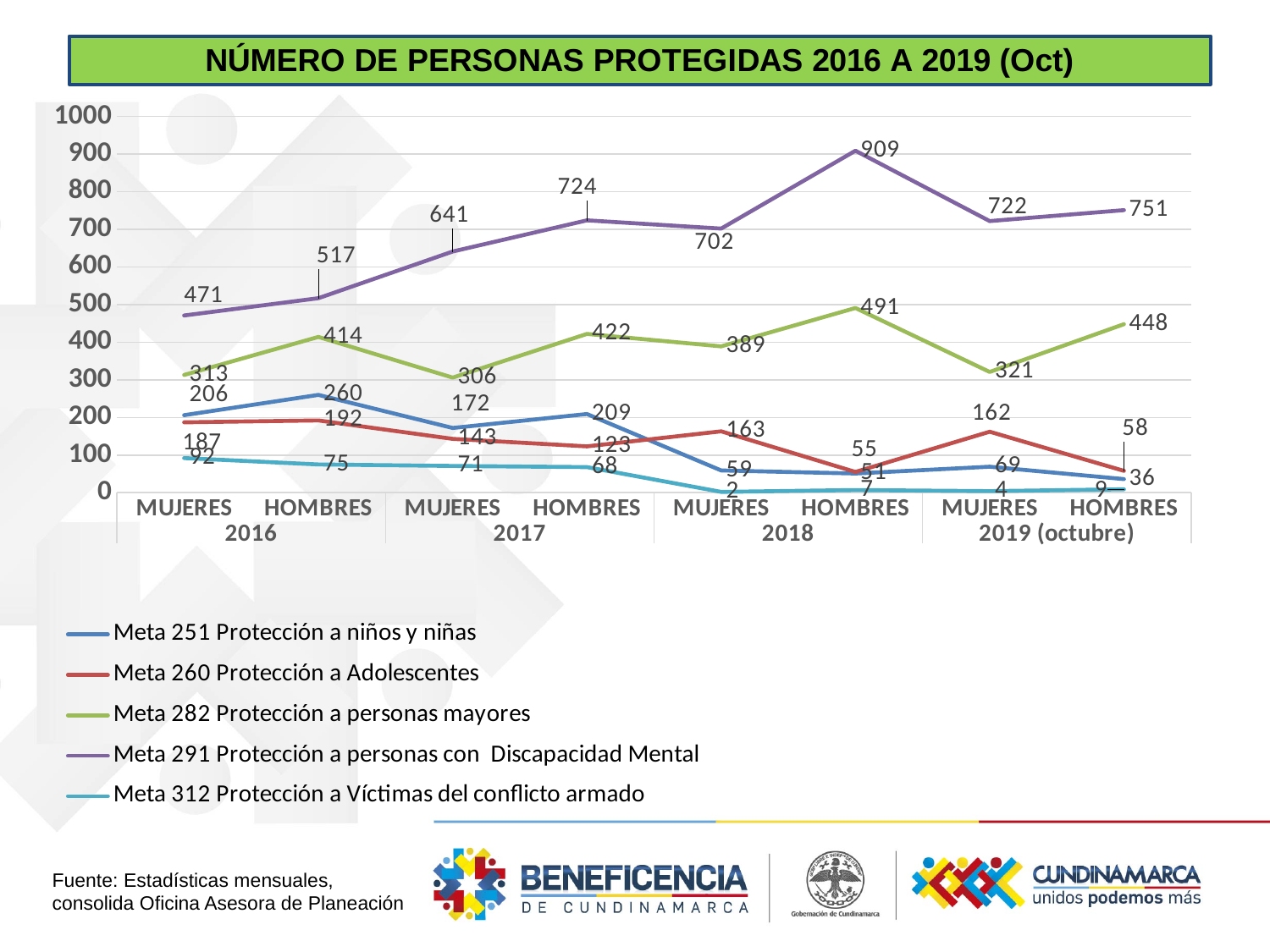
How many data points does each line have along the x axis? 8 What is the value for Meta 291 Protección a personas con Discapacidad Mental for MUJERES in 2016? 471 At which category does Meta 291 Protección a personas con Discapacidad Mental reach its highest value? HOMBRES 2018 What type of chart is shown on the slide? Line chart Is the value for Meta 291 Protección a personas con Discapacidad Mental for HOMBRES in 2018 greater or less than 800? greater What is the value for Meta 282 Protección a personas mayores for HOMBRES in 2019 (octubre)? 448 What is the difference between the highest value (909) and the 2016 MUJERES value (471) of Meta 291 Protección a personas con Discapacidad Mental? 438 Which is larger for HOMBRES in 2017: Meta 291 Protección a personas con Discapacidad Mental or Meta 282 Protección a personas mayores? Meta 291 Protección a personas con Discapacidad Mental At which category does Meta 282 Protección a personas mayores have its lowest value? MUJERES 2017 What is the value for Meta 291 Protección a personas con Discapacidad Mental for HOMBRES in 2018? 909 What is the title of the chart? NÚMERO DE PERSONAS PROTEGIDAS 2016 A 2019 (Oct) How many series does the legend list? 5